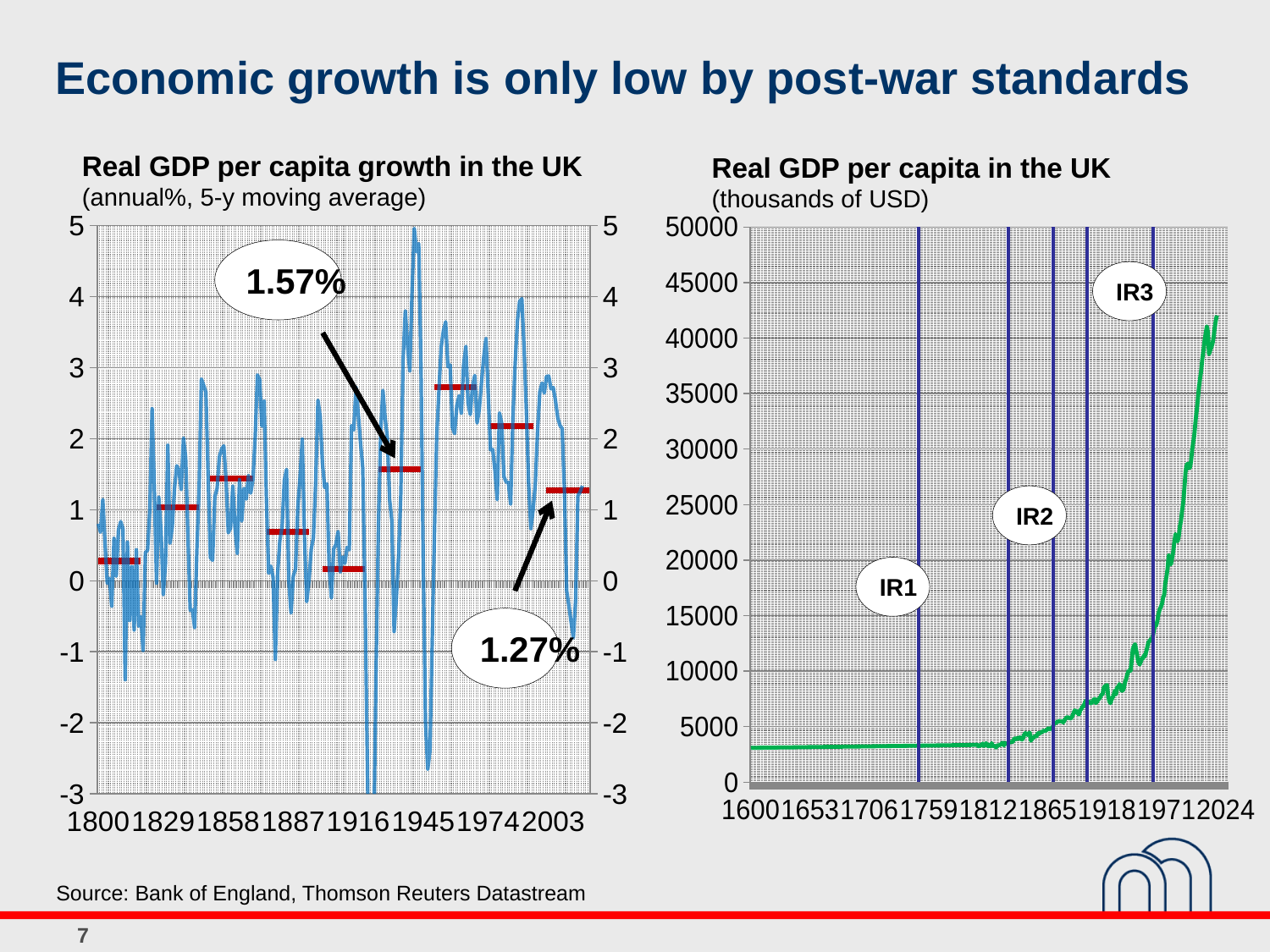
On the left chart, what are the two annotated average growth values shown in the callouts? 1.57% and 1.27% On the right chart, is the value at 1600 greater or less than 5000? less On the left chart, what is the first year shown on the x axis? 1800 On the right chart, what unit is stated in the subtitle? thousands of USD On the right chart, how many labelled industrial revolution markers (IR) are shown? 3 On the left chart, what is the difference between the annotated values 1.57% and 1.27%? 0.3 percentage points On the right chart, does real GDP per capita rise or fall over time from 1600 to 2024? rise On the left chart, which annotated value is larger, 1.57% or 1.27%? 1.57% What kind of chart is the right chart, 'Real GDP per capita in the UK'? line chart On the right chart, what is the last year shown on the x axis? 2024 What kind of chart is the left chart, 'Real GDP per capita growth in the UK'? line chart